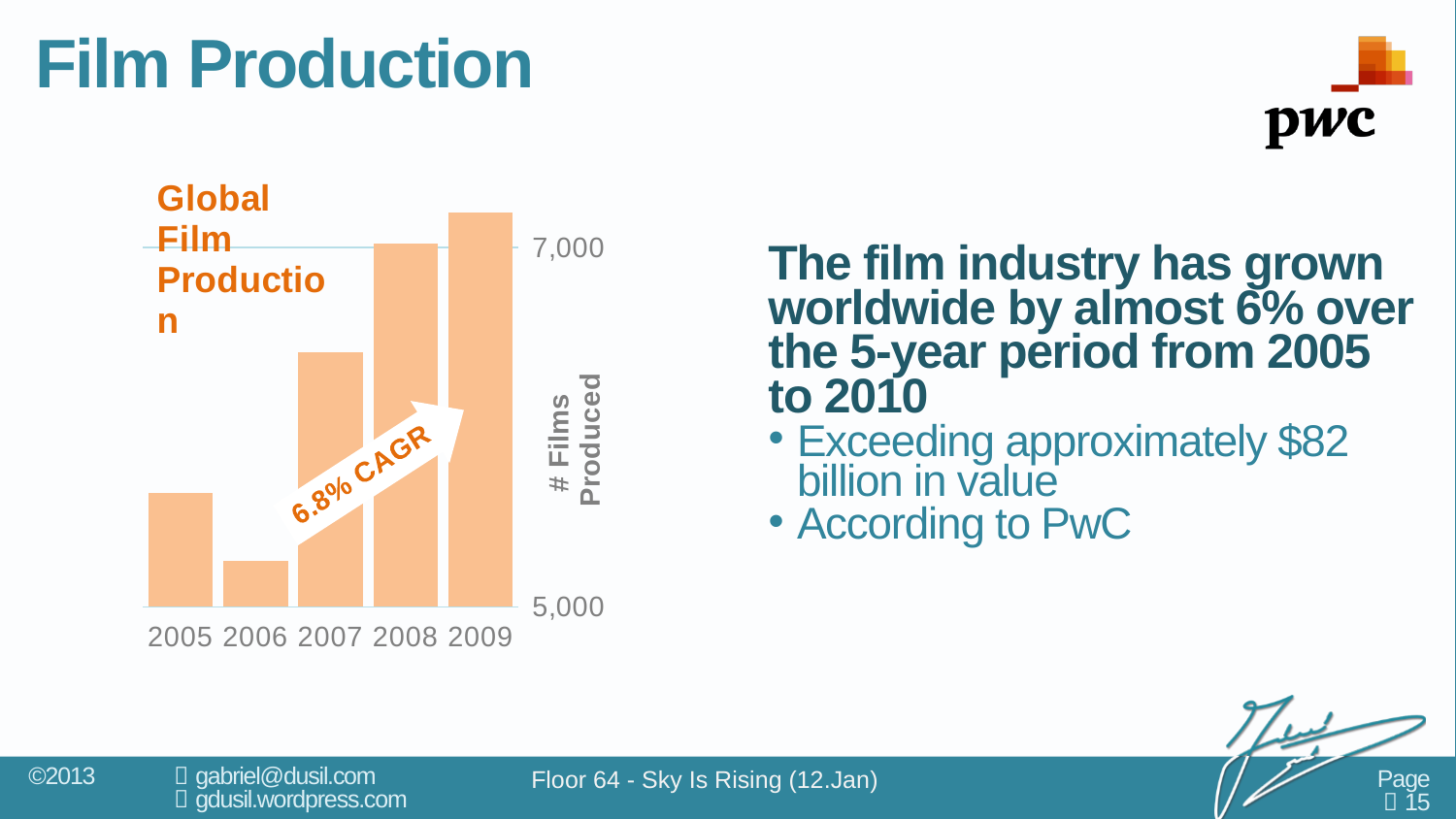
Which year has the lowest number of films produced? 2006 Which year has the highest number of films produced? 2009 Is the value for 2005 greater or less than 7,000? less Which year has the larger value, 2006 or 2007? 2007 How many years are shown on the x axis of the chart? 5 What kind of chart is shown on the slide? bar chart What is the title of the chart? Global Film Production Which year has the larger value, 2005 or 2008? 2008 Do the values rise or fall from 2006 to 2009? rise Is the value for 2006 greater or less than 5,000? greater What CAGR is annotated on the chart? 6.8% CAGR Is the value for 2009 greater or less than 7,000? greater